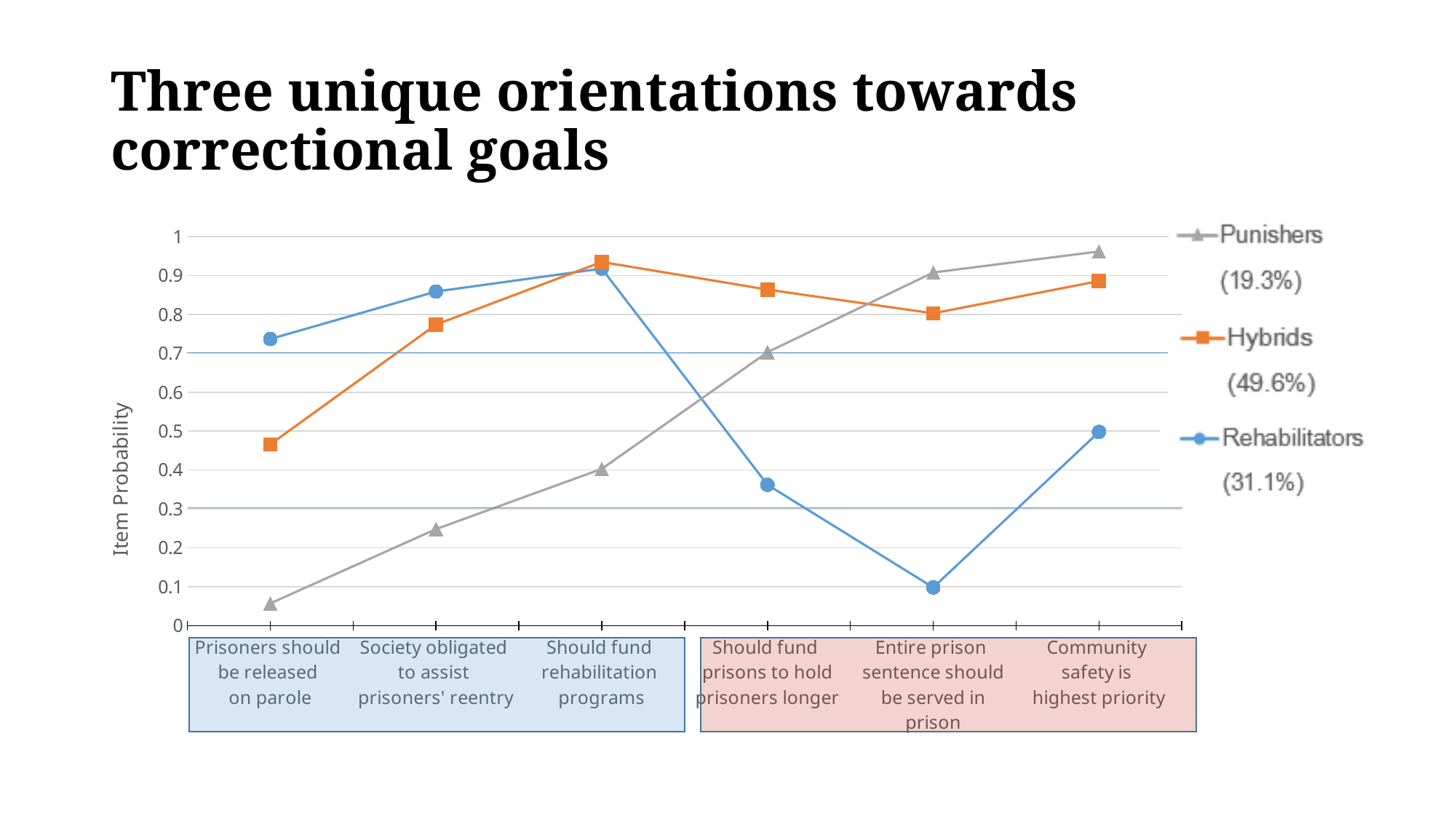
Which series has the lowest value for "Society obligated to assist prisoners' reentry"? Punishers Is the Hybrids value for "Should fund rehabilitation programs" greater or less than 0.9? greater What kind of chart is shown on the slide? line chart Which series has the highest value for "Community safety is highest priority"? Punishers How many series does the legend list? 3 Is the Punishers value for "Prisoners should be released on parole" greater or less than 0.1? less Is the Rehabilitators value for "Entire prison sentence should be served in prison" greater or less than 0.2? less How many categories are shown along the x axis? 6 Do the Punishers values rise or fall from left to right along the x axis? rise What percentage is shown next to Hybrids in the legend? 49.6% For "Should fund prisons to hold prisoners longer", which is larger: the Hybrids value or the Rehabilitators value? Hybrids For which category is the Rehabilitators value lowest? Entire prison sentence should be served in prison